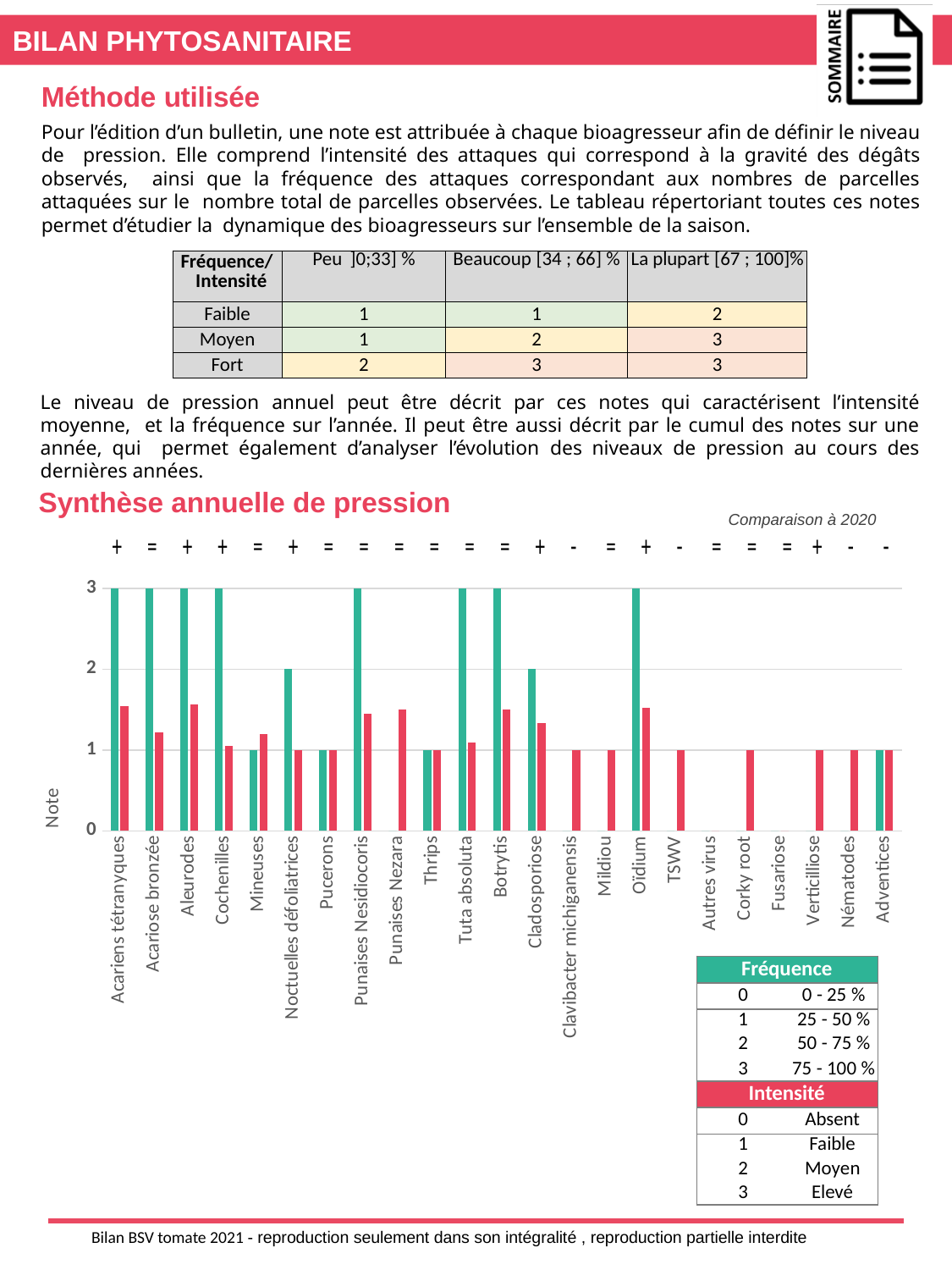
What kind of chart is shown under 'Synthèse annuelle de pression'? bar chart In the 'Synthèse annuelle de pression' chart, which has the taller green bar, Oïdium or Nématodes? Oïdium In the 'Synthèse annuelle de pression' chart, what is the value of the green bar for Noctuelles défoliatrices? 2 What is the label on the vertical axis of the 'Synthèse annuelle de pression' chart? Note In the 'Synthèse annuelle de pression' chart, what is the value of the green bar for Tuta absoluta? 3 In the 'Synthèse annuelle de pression' chart, which has the taller green bar, Noctuelles défoliatrices or Pucerons? Noctuelles défoliatrices In the 'Synthèse annuelle de pression' chart, what is the value of the green bar for Mineuses? 1 How many bioagresseur categories are listed along the x axis of the 'Synthèse annuelle de pression' chart? 23 In the 'Synthèse annuelle de pression' chart, is the red bar for Acariose bronzée greater or less than 2? less In the 'Synthèse annuelle de pression' chart, what is the value of the green bar for Cladosporiose? 2 In the 'Synthèse annuelle de pression' chart, what is the difference between the green bar for Acariens tétranyques and the green bar for Mineuses? 2 In the 'Synthèse annuelle de pression' chart, is the red bar for Acariens tétranyques greater or less than 1? greater